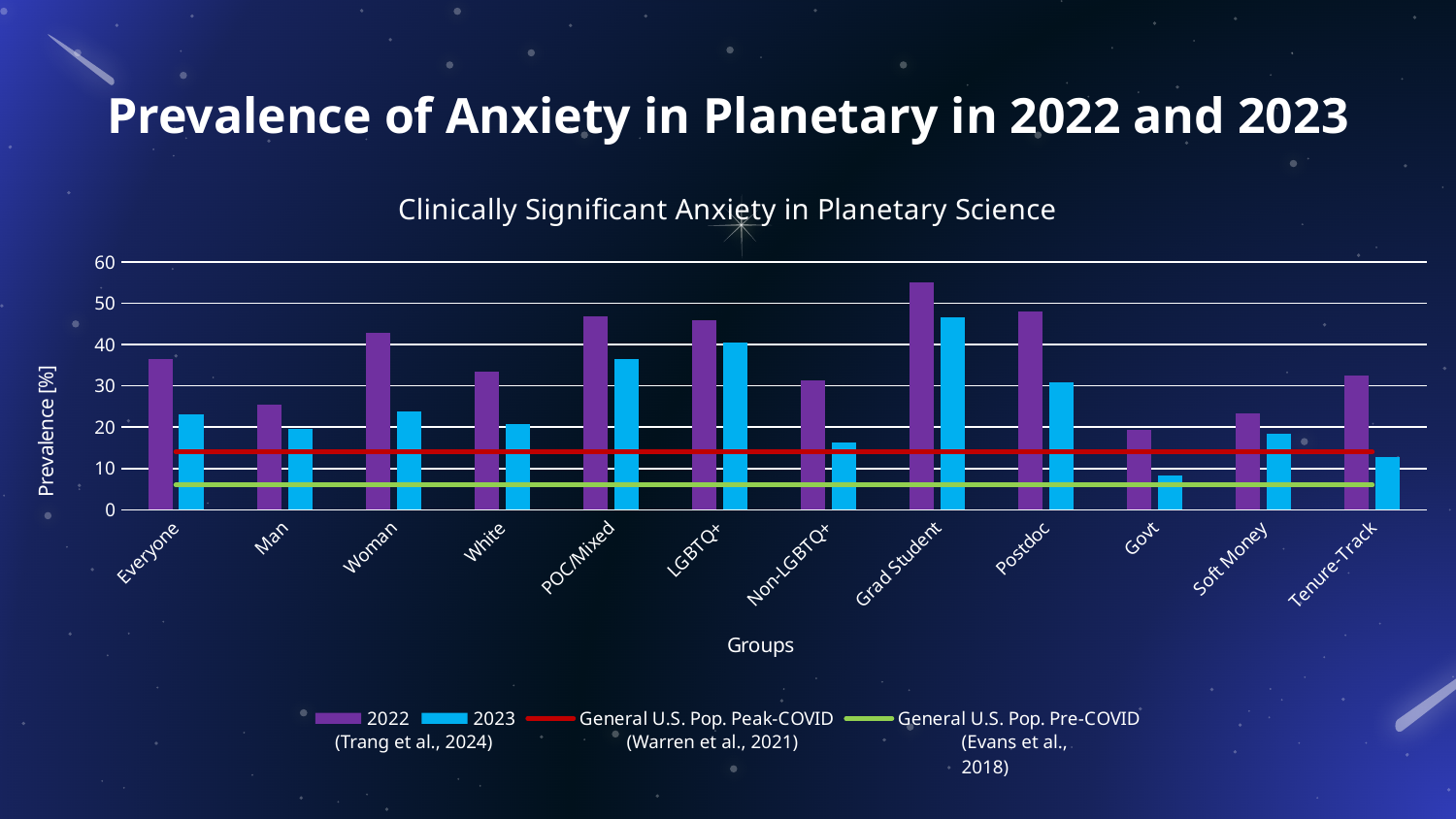
Is the 2022 value for Grad Student greater or less than 50? greater Which group has the highest 2022 prevalence? Grad Student How many groups are shown along the x axis of the chart? 12 Which is larger: the 2022 value for Woman or the 2022 value for Man? Woman Is the 2023 value for Govt greater or less than 10? less Which group has the lowest 2022 prevalence? Govt What type of chart is shown on the slide? Combination bar and line chart Is the 2022 value for Woman greater or less than 40? greater What is the label of the chart's vertical axis? Prevalence [%] For every group, is the 2023 bar higher or lower than the 2022 bar? lower How many entries does the chart's legend list? 4 Which group has the lowest 2023 prevalence? Govt